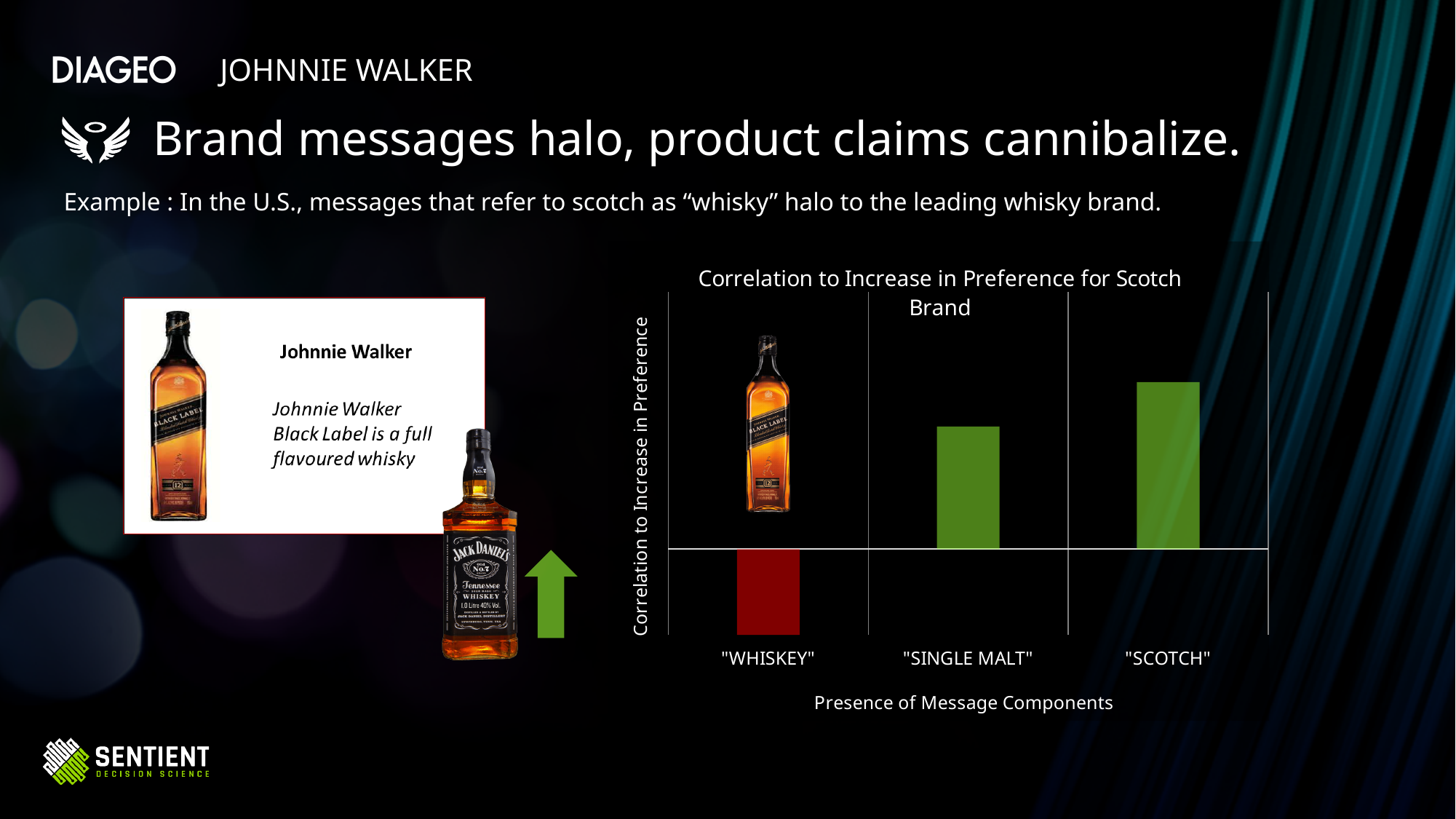
Which message component has the lowest correlation to increase in preference? "WHISKEY" Which message component is the only one with a negative correlation in the chart? "WHISKEY" Do the bar values rise or fall moving from "WHISKEY" to "SCOTCH" along the x axis? rise Which has a larger correlation to increase in preference, "WHISKEY" or "SINGLE MALT"? "SINGLE MALT" What is the title of the chart? Correlation to Increase in Preference for Scotch Brand Which has a larger correlation to increase in preference, "SINGLE MALT" or "SCOTCH"? "SCOTCH" How many message components are shown on the x axis of the chart? 3 What is the label of the x axis of the chart? Presence of Message Components Which message component has the highest correlation to increase in preference? "SCOTCH" What type of chart is shown on the slide? bar chart